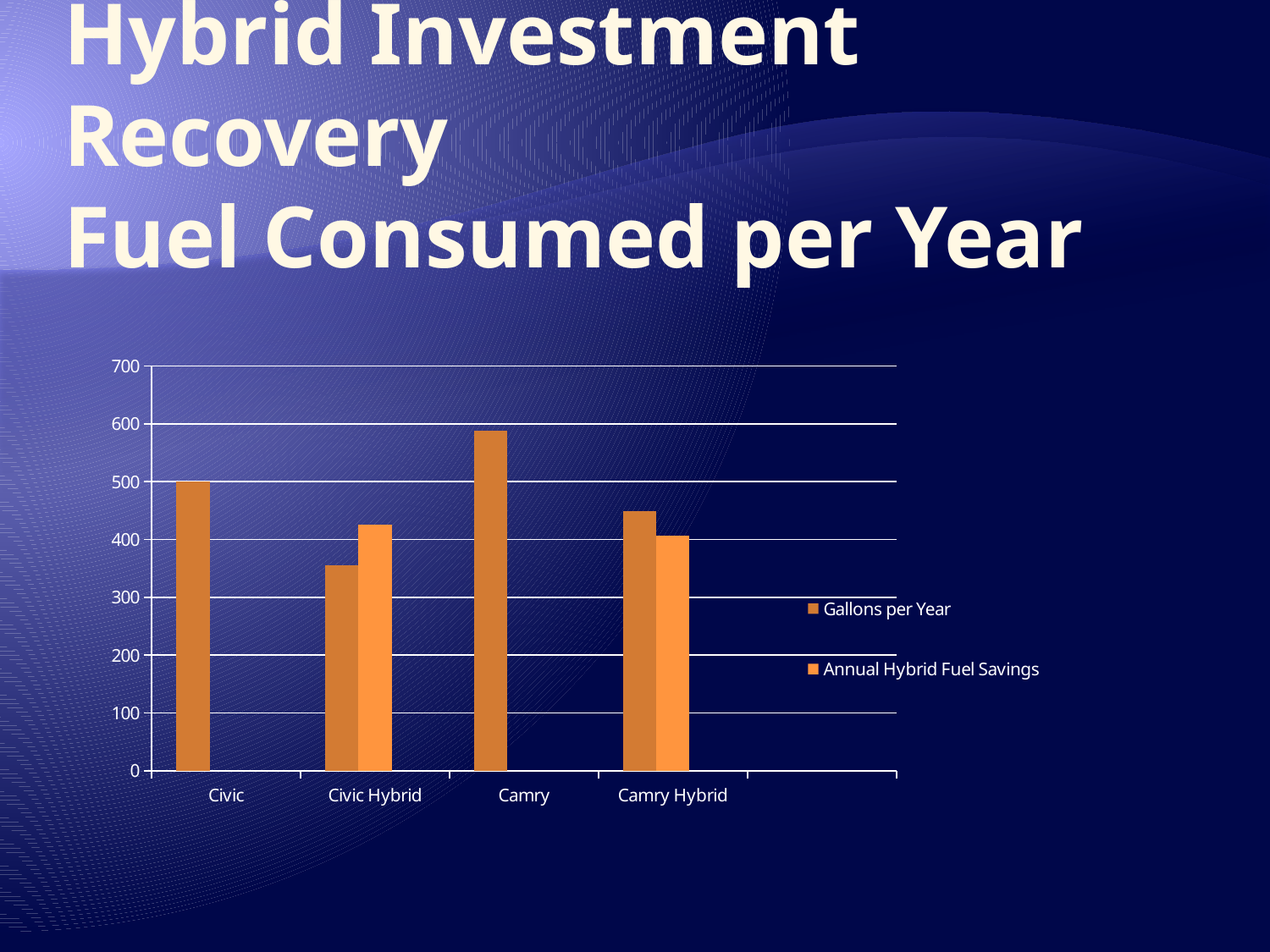
Which has more Gallons per Year, Camry or Camry Hybrid? Camry Is the Annual Hybrid Fuel Savings value for Civic Hybrid greater or less than 400? greater What kind of chart is shown on the slide? bar chart Is the Gallons per Year value for Camry greater or less than 500? greater Is the Gallons per Year value for Civic Hybrid greater or less than 400? less Which vehicle has the lowest Gallons per Year? Civic Hybrid Which vehicle has the highest Gallons per Year? Camry What are the two series named in the legend? Gallons per Year and Annual Hybrid Fuel Savings How many series does the legend list? 2 Which has more Gallons per Year, Civic or Civic Hybrid? Civic How many vehicle categories are shown on the x axis? 4